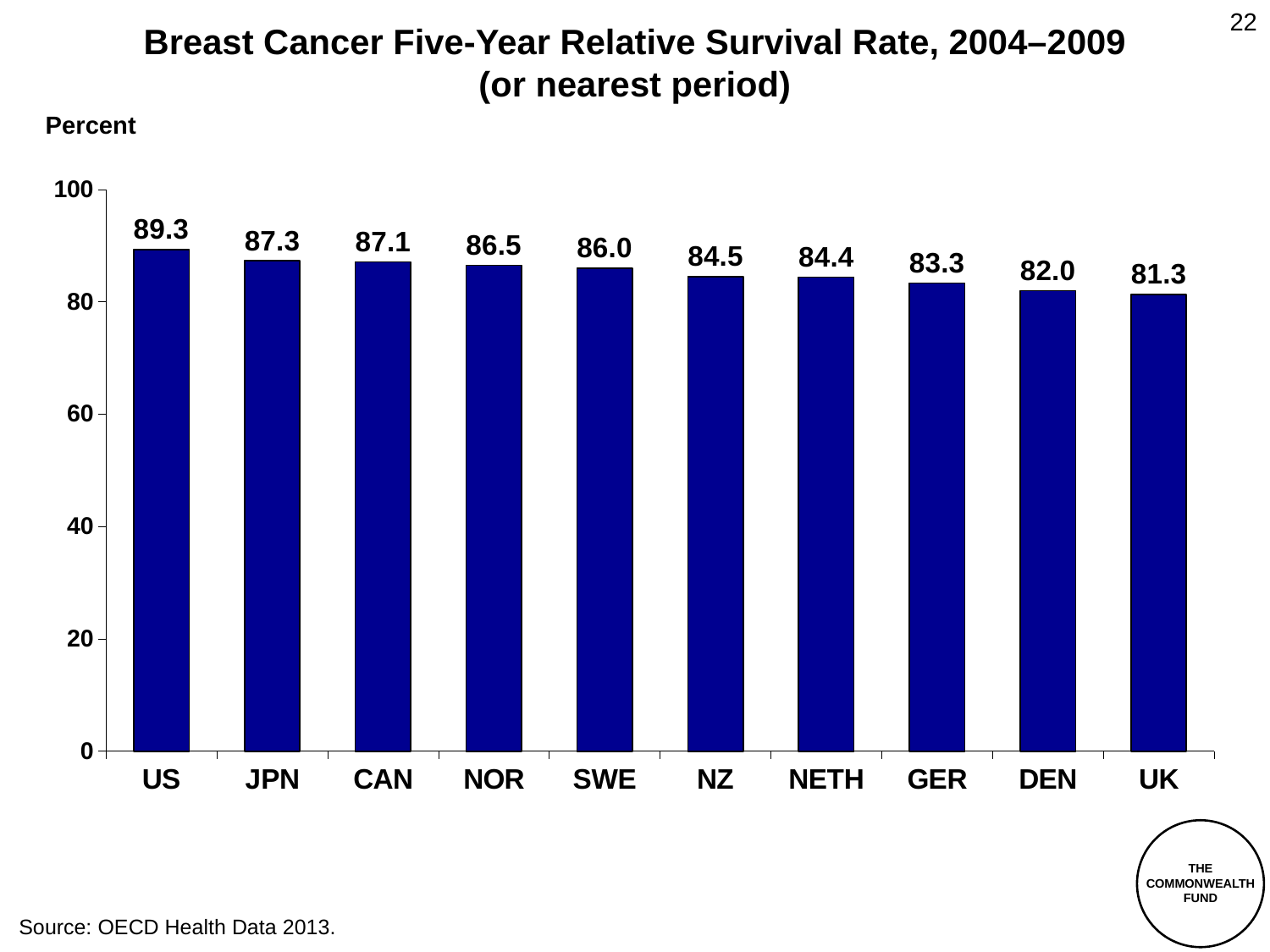
Which has a higher value, NOR or SWE? NOR What kind of chart is shown on the slide? Bar chart Is the value for DEN greater or less than 80? greater What is the value shown for NZ? 84.5 What is the difference between the values for the US and the UK? 8.0 What is the value shown for GER? 83.3 Which country has the lowest five-year relative survival rate? UK What is the difference between the values for JPN and DEN? 5.3 Do the values rise or fall from left to right across the x axis? Fall What is the breast cancer five-year relative survival rate for the US? 89.3 How many countries are shown on the chart? 10 Which country has the highest five-year relative survival rate? US